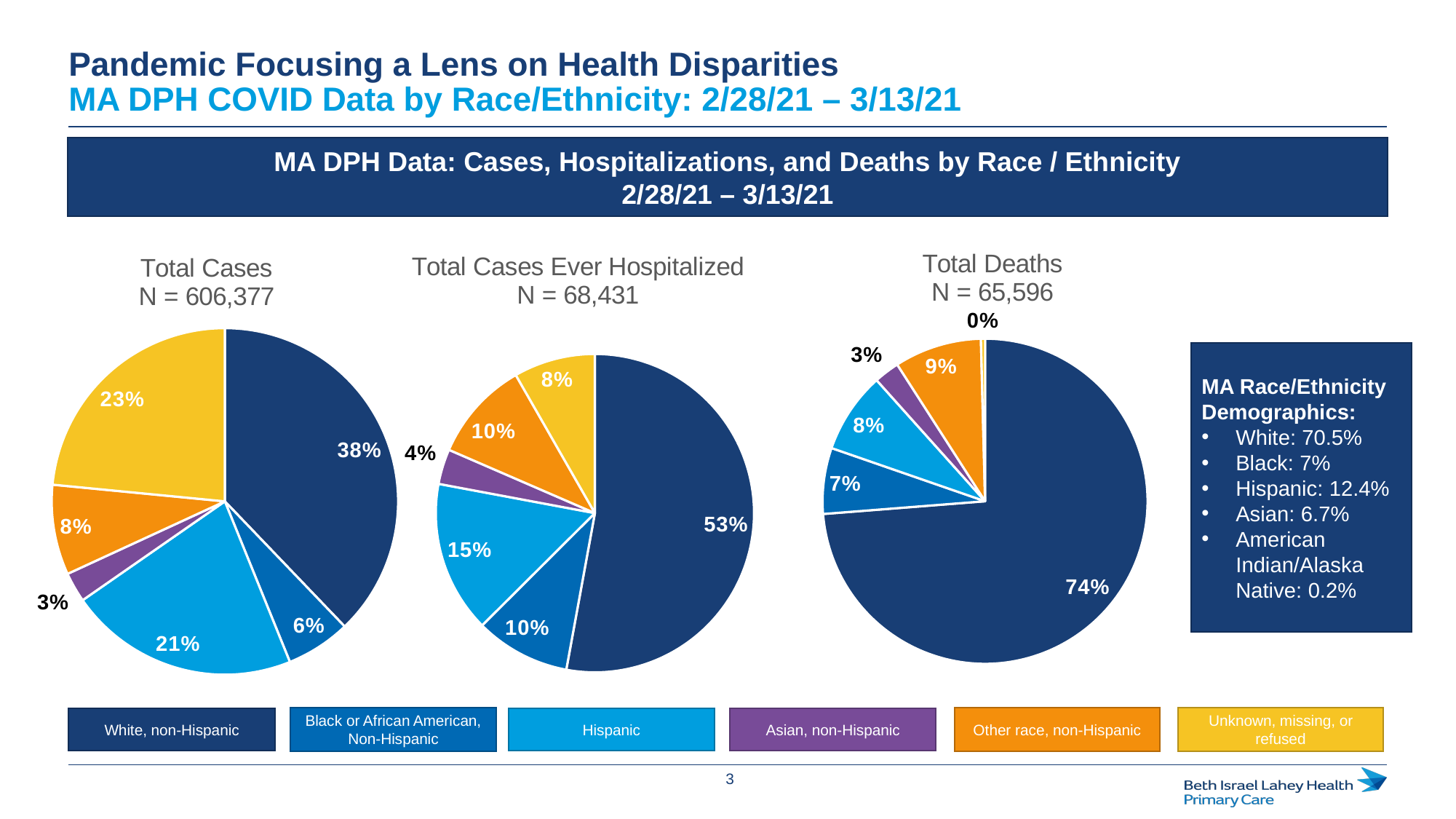
How many categories does the legend at the bottom of the slide list? 6 In the Total Cases pie chart, what share is Hispanic? 21% In the Total Cases Ever Hospitalized pie chart, which is larger: the Hispanic share or the Black or African American, Non-Hispanic share? Hispanic In the Total Cases pie chart, what is the difference between the Unknown, missing, or refused share and the Other race, non-Hispanic share? 15% What is the N value shown under the Total Deaths pie chart title? N = 65,596 In the Total Deaths pie chart, what share is White, non-Hispanic? 74% In the Total Cases pie chart, which category has the smallest share? Asian, non-Hispanic In the Total Cases Ever Hospitalized pie chart, what share is White, non-Hispanic? 53% What kind of charts are shown on the slide? Pie charts In the Total Cases Ever Hospitalized pie chart, which category has the largest share? White, non-Hispanic